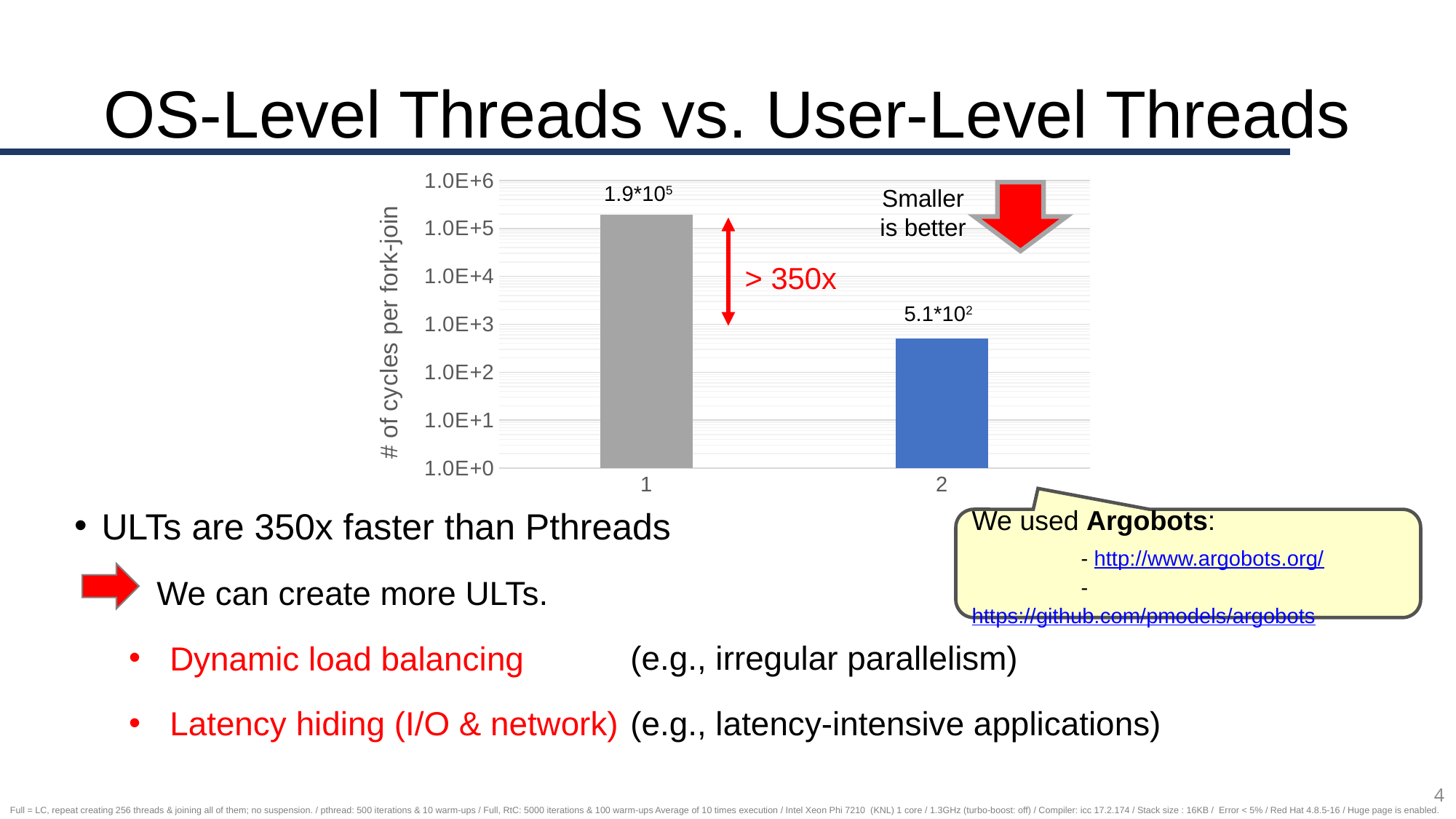
What value is labelled on the bar for category 2? 5.1*10² Is the value for category 1 greater or less than 1.0E+5? greater Do the values rise or fall from category 1 to category 2? fall Is the value for category 2 greater or less than 1.0E+3? less Which category has the higher number of cycles per fork-join? 1 What value is labelled on the bar for category 1? 1.9*10⁵ Is the value for category 1 larger or smaller than the value for category 2? larger How many bars are plotted in the chart? 2 What colour is the bar for category 2? blue Which category has the lowest number of cycles per fork-join? 2 What is the label of the y-axis of the chart? # of cycles per fork-join What kind of chart is shown on the slide? bar chart